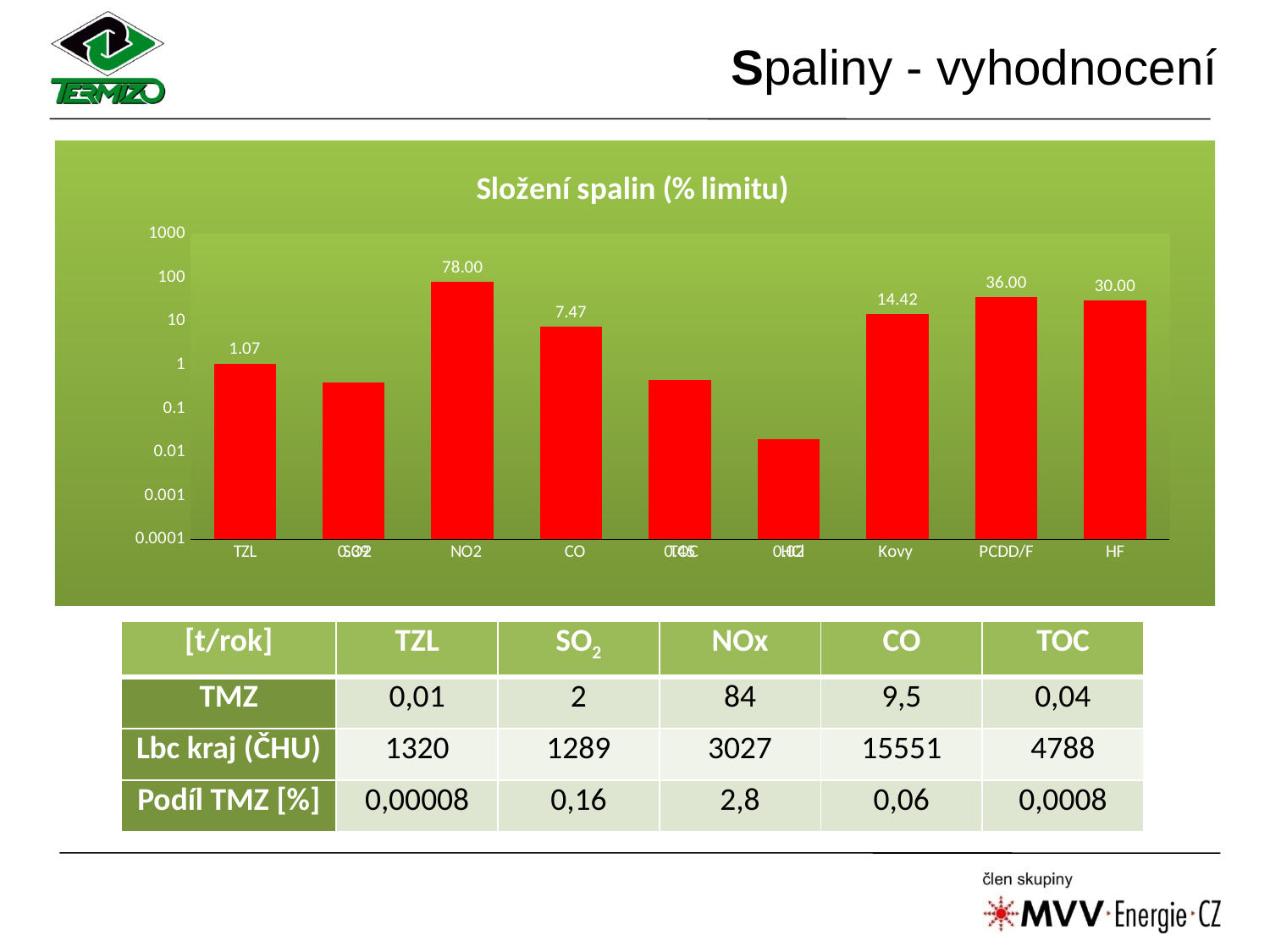
What is the value for NO2 in the chart? 78.00 What kind of chart is shown on the slide? Bar chart What is the difference between the values for NO2 and CO? 70.53 What is the difference between the values for PCDD/F and HF? 6.00 Which category has the highest value in the chart? NO2 Which is larger, the value for PCDD/F or the value for HF? PCDD/F How many bars are plotted in the chart? 9 What is the value for HF in the chart? 30.00 What is the value for TZL in the chart? 1.07 What is the value for Kovy in the chart? 14.42 Which is larger, the value for CO or the value for Kovy? Kovy What is the title of the chart? Složení spalin (% limitu)